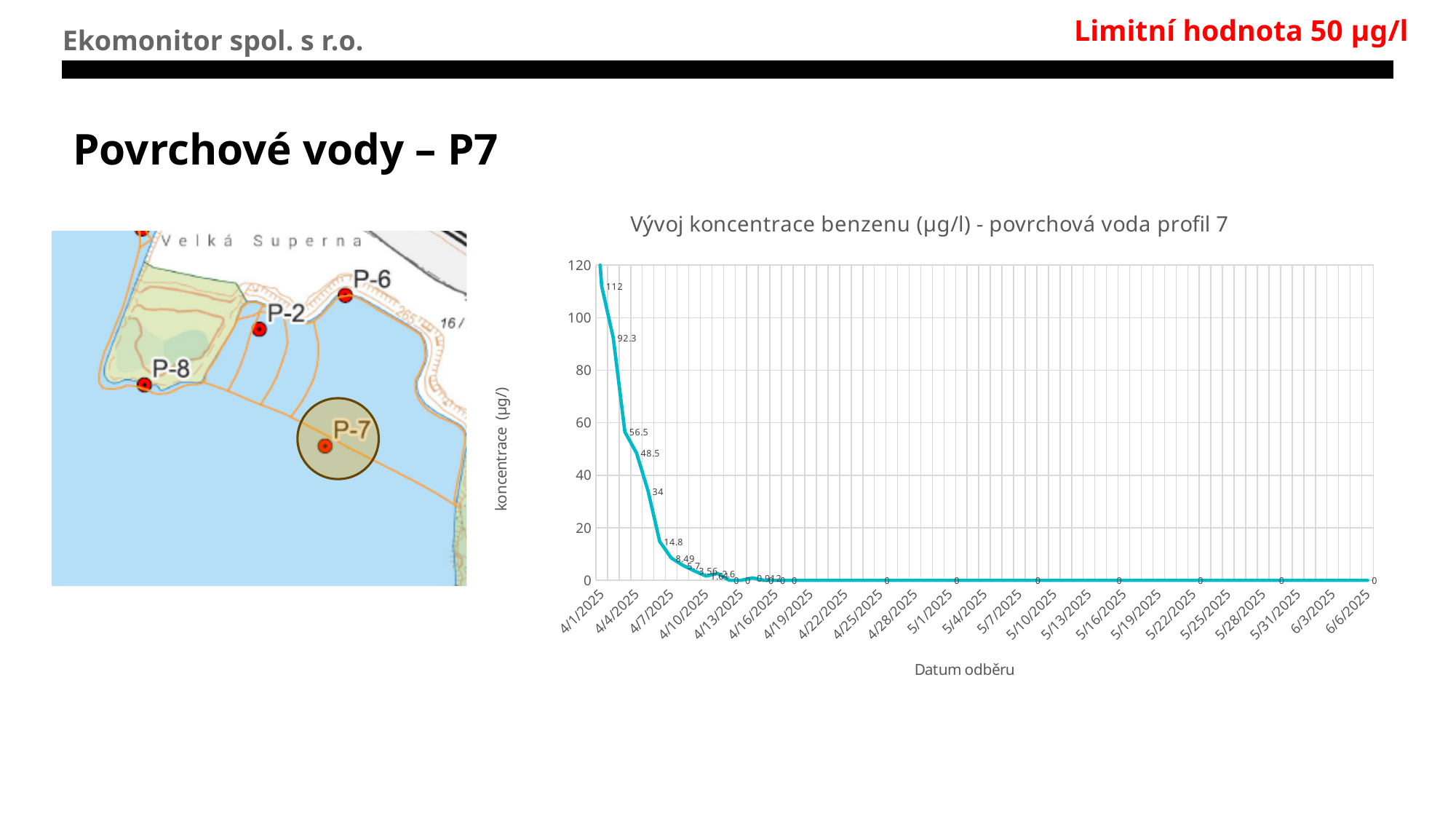
What is the label of the y axis? koncentrace (µg/l) What is the benzene concentration on 4/1/2025? 112 What is the title of the chart? Vývoj koncentrace benzenu (µg/l) - povrchová voda profil 7 Is the value for 6/6/2025 greater or less than 20? less Which is larger, the value on 4/1/2025 or the value on 6/6/2025? 4/1/2025 Do the values rise or fall along the x axis from 4/1/2025 onward? fall Is the value for 4/1/2025 greater or less than 100? greater How many date labels are shown on the x axis? 23 What is the highest labelled value on the chart? 112 What is the lowest labelled value on the chart? 0 What type of chart is shown on the slide? line chart What is the difference between the first labelled value (112) and the second labelled value (92.3)? 19.7